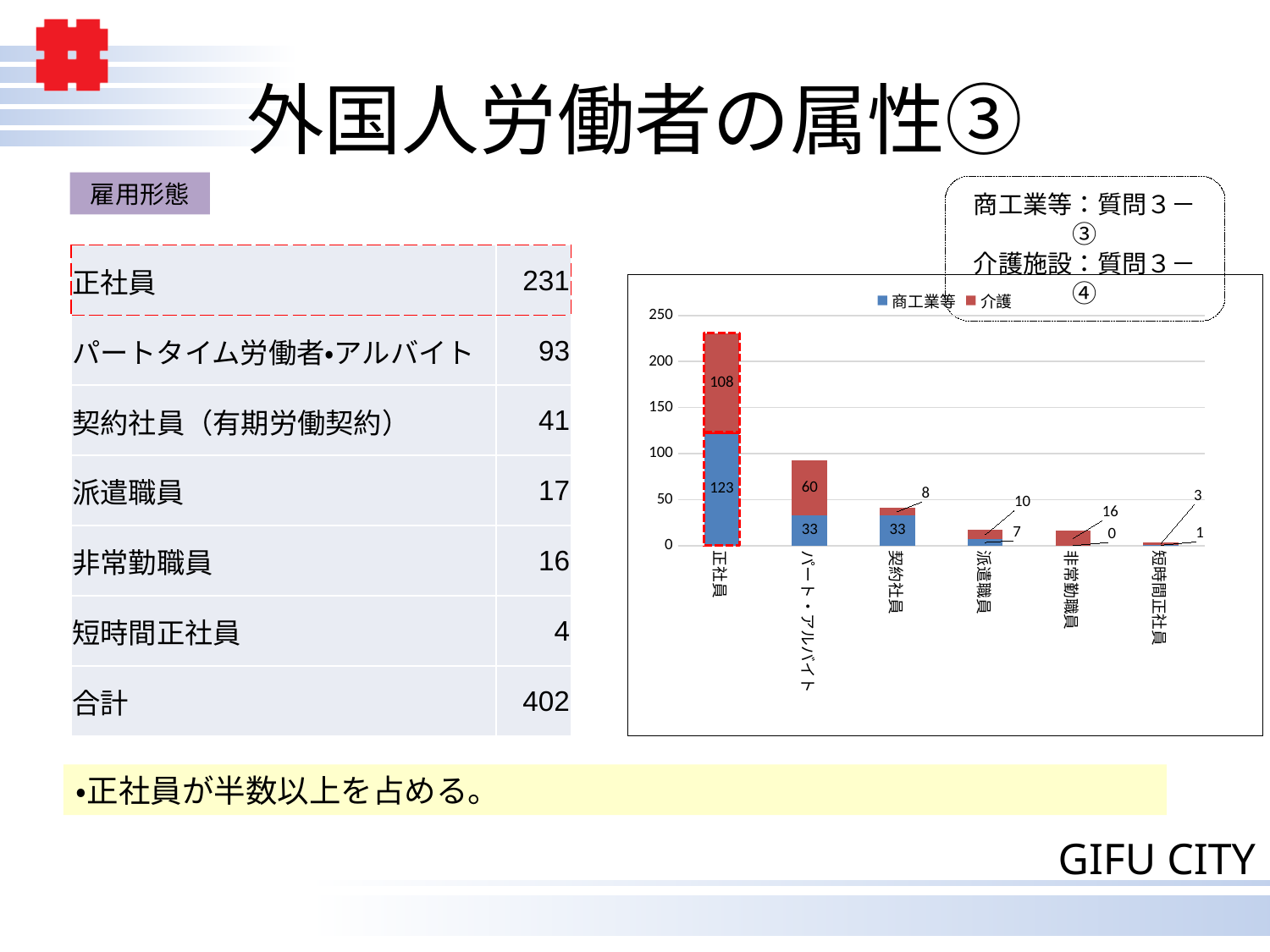
How many series does the chart legend list? 2 What kind of chart is shown on the slide? Stacked bar chart How many categories are shown on the x axis of the chart? 6 What is the value of 介護 for 正社員 in the chart? 108 What is the total of the stacked bar for 正社員? 231 What is the difference between the 介護 value and the 商工業等 value for パート・アルバイト? 27 What is the total of the stacked bar for 派遣職員? 17 What is the value of 商工業等 for 非常勤職員 in the chart? 0 Which category has the lowest total bar in the chart? 短時間正社員 Which category has the highest total bar in the chart? 正社員 What is the value of 商工業等 for 正社員 in the chart? 123 What is the value of 介護 for パート・アルバイト in the chart? 60